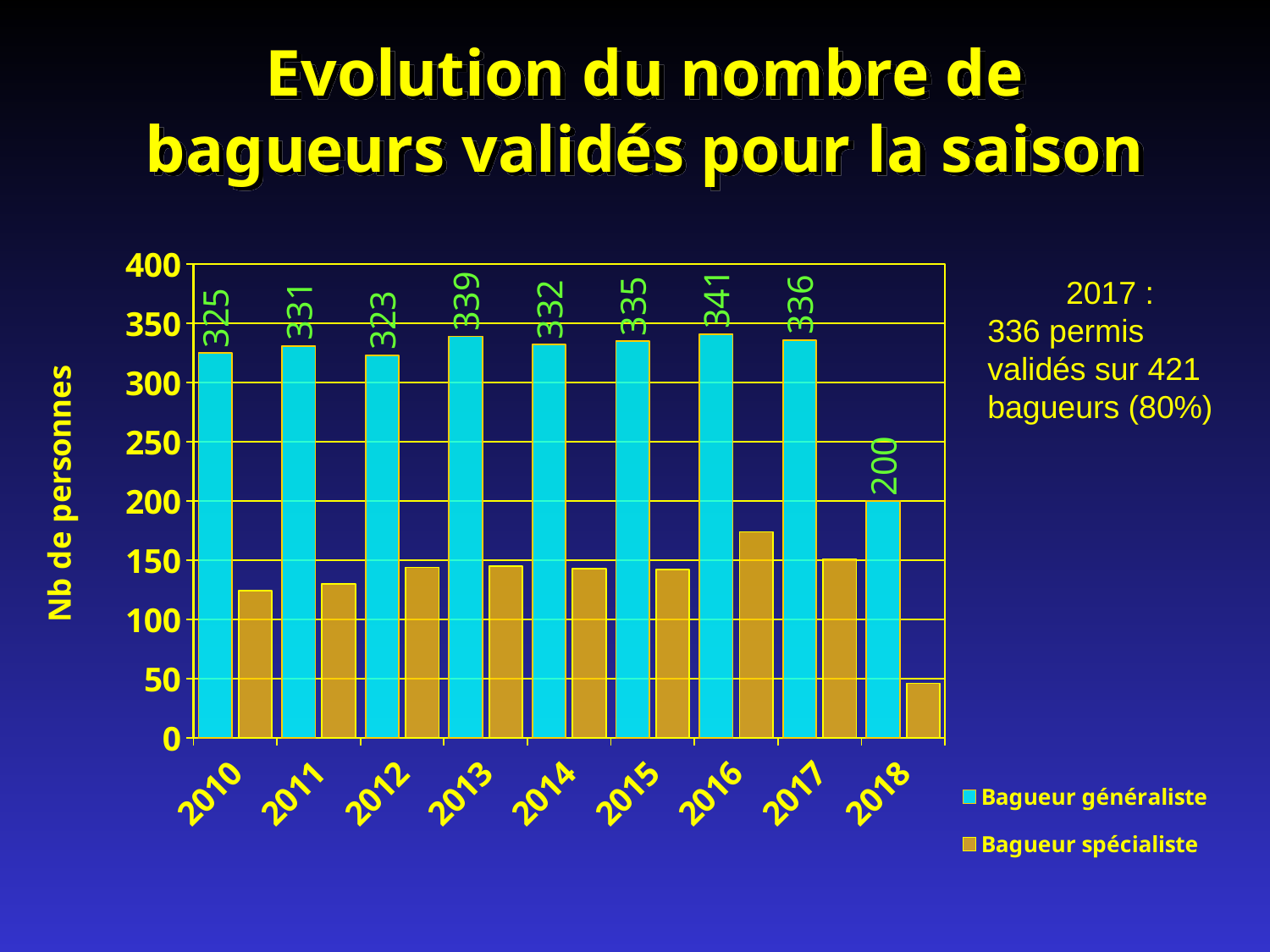
What is the value for Bagueur généraliste in 2018? 200 Which year has the highest value for Bagueur généraliste? 2016 Which year has the lowest value for Bagueur généraliste? 2018 What is the difference between the Bagueur généraliste values for 2017 and 2018? 136 What is the value for Bagueur généraliste in 2012? 323 Is the value for Bagueur spécialiste in 2016 greater or less than 150? greater How many years are shown on the x axis? 9 Which is larger, the Bagueur généraliste value for 2013 or for 2014? 2013 How many series does the legend list? 2 What is the value for Bagueur généraliste in 2016? 341 What kind of chart is shown on the slide? Bar chart